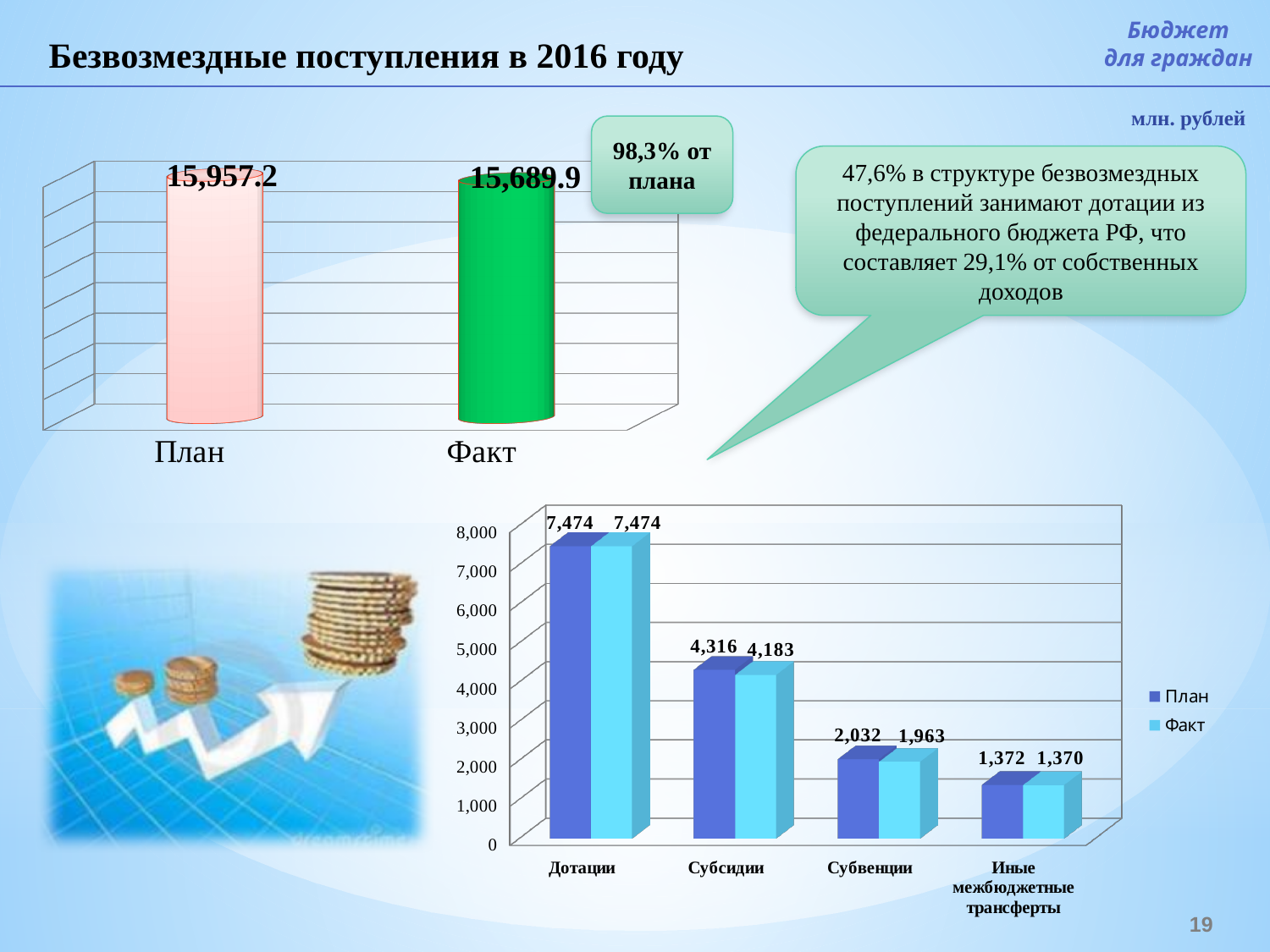
In the bottom-right chart, how many categories are shown on the x axis? 4 In the top-left chart, what is the value for Факт? 15,689.9 In the top-left chart, what is the value for План? 15,957.2 In the bottom-right chart, what is the difference between the План and Факт values for Субсидии? 133 In the bottom-right chart, which category has the highest Факт value? Дотации In the bottom-right chart, which category has the lowest План value? Иные межбюджетные трансферты In the bottom-right chart, how many series does the legend list? 2 In the bottom-right chart, what is the Факт value for Субвенции? 1,963 What kind of chart is the bottom-right chart? Bar chart In the top-left chart, what is the difference between План and Факт? 267.3 In the bottom-right chart, what is the План value for Субсидии? 4,316 In the top-left chart, which is larger, План or Факт? План